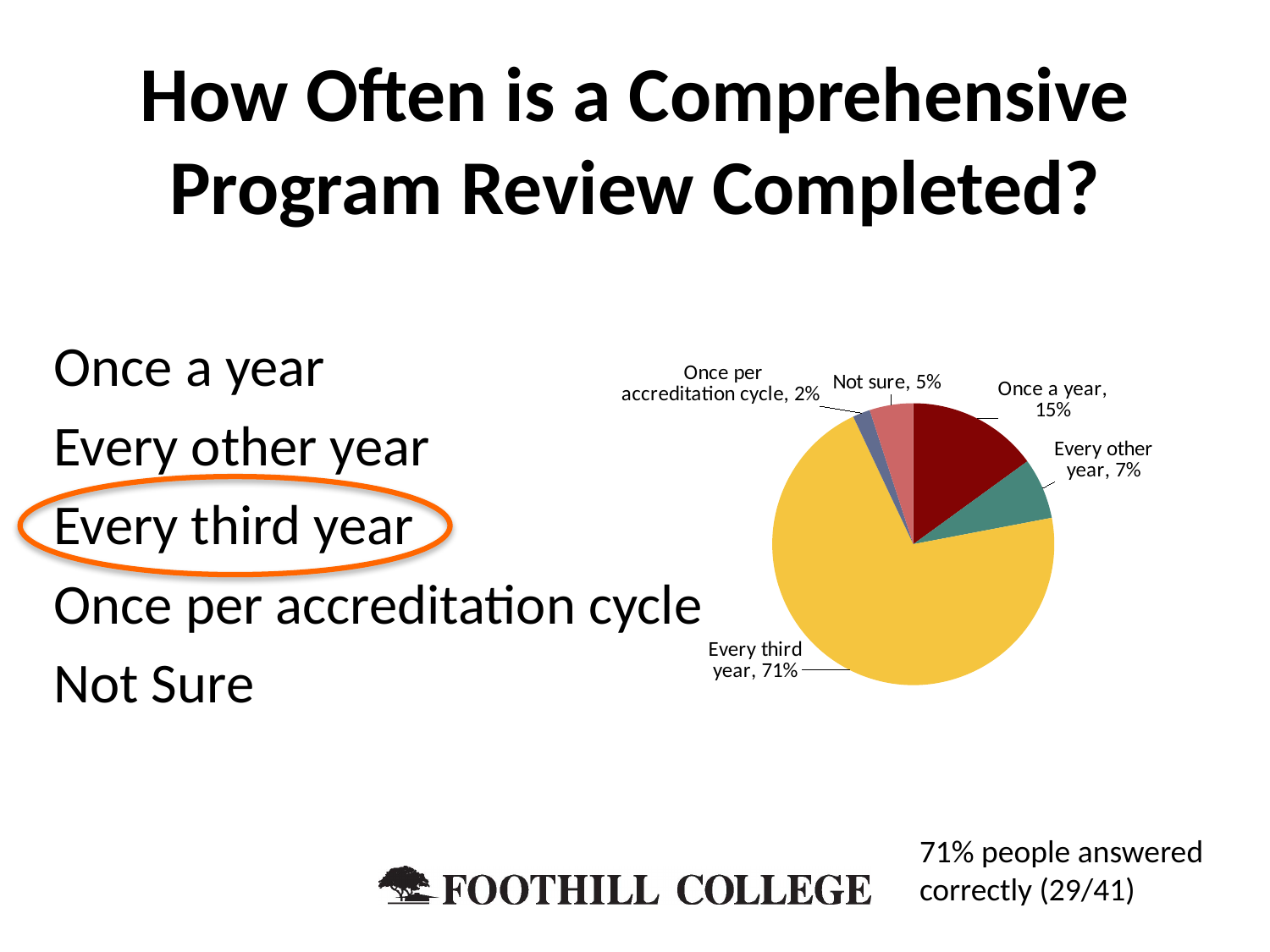
What is the value for "Every other year" in the pie chart? 7% What colour is the "Every third year" slice in the pie chart? yellow What is the difference between the "Once a year" and "Every other year" slices? 8% What is the value for "Once a year" in the pie chart? 15% How many slices does the pie chart have? 5 What is the value for "Once per accreditation cycle" in the pie chart? 2% What is the value for "Not sure" in the pie chart? 5% What kind of chart is shown on the slide? pie chart Which category has the largest slice of the pie chart? Every third year Which category has the smallest slice of the pie chart? Once per accreditation cycle Which is larger, the "Not sure" slice or the "Every other year" slice? Every other year What share of the pie does "Every third year" represent? 71%